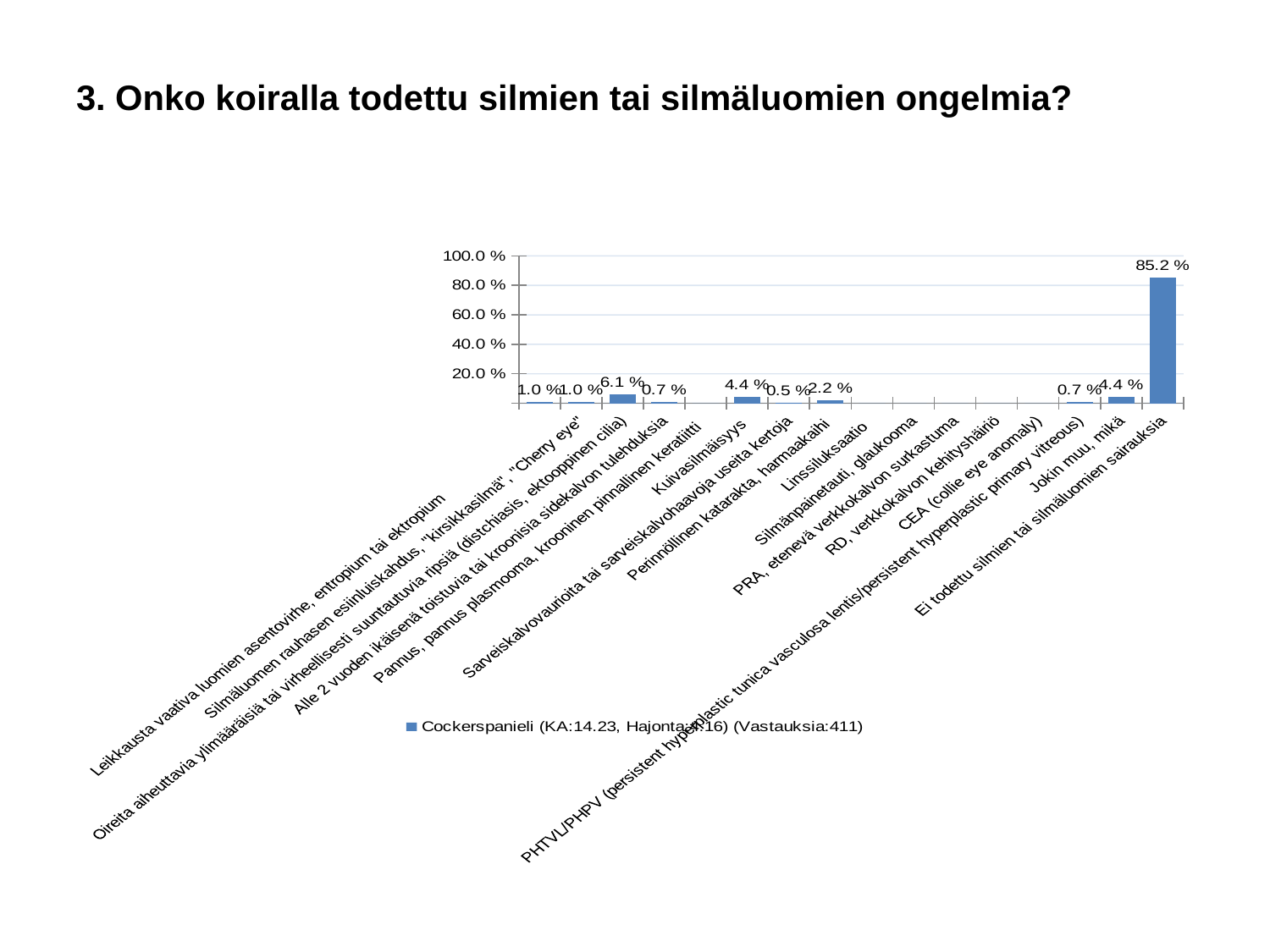
What is the value for "Ei todettu silmien tai silmäluomien sairauksia"? 85.2 % Is the value for "Ei todettu silmien tai silmäluomien sairauksia" greater or less than 80.0 %? greater What is the value for "Sarveiskalvovaurioita tai sarveiskalvohaavoja useita kertoja"? 0.5 % What is the difference between the value for "Ei todettu silmien tai silmäluomien sairauksia" and the value for "Oireita aiheuttavia ylimääräisiä tai virheellisesti suuntautuvia ripsiä (distichiasis, ektooppinen cilia)"? 79.1 % Which is larger, the value for "Kuivasilmäisyys" or the value for "Perinnöllinen katarakta, harmaakaihi"? Kuivasilmäisyys Which category has the highest value? Ei todettu silmien tai silmäluomien sairauksia How many series does the legend list? 1 What is the value for "Kuivasilmäisyys"? 4.4 % What is the value for "Perinnöllinen katarakta, harmaakaihi"? 2.2 % What is the legend entry for the series shown in the chart? Cockerspanieli (KA:14.23, Hajonta:4.16) (Vastauksia:411) What is the value for "Oireita aiheuttavia ylimääräisiä tai virheellisesti suuntautuvia ripsiä (distichiasis, ektooppinen cilia)"? 6.1 % What kind of chart is shown on the slide? bar chart